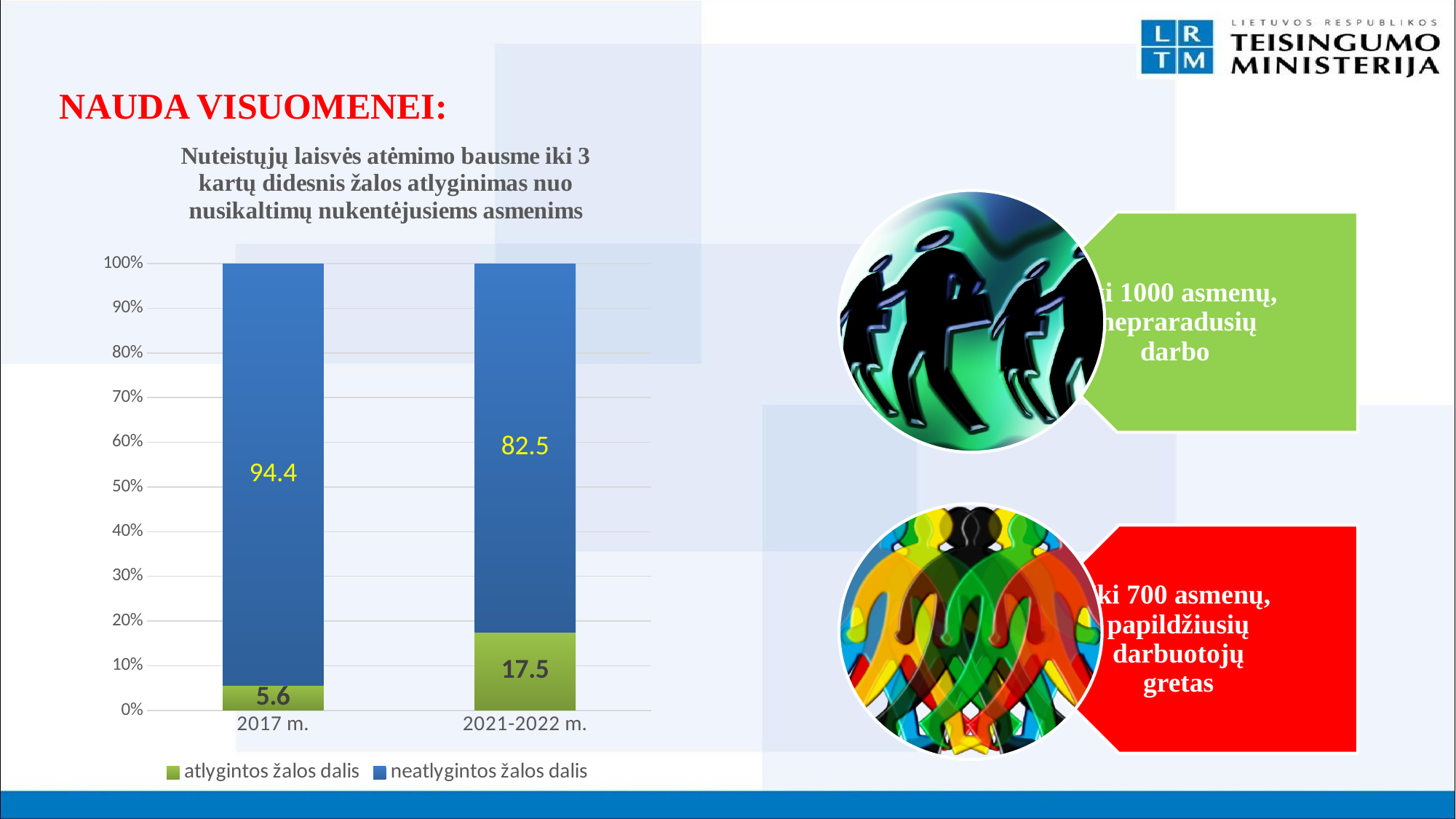
Which category has the lowest value for neatlygintos žalos dalis? 2021-2022 m. What is the difference between the neatlygintos žalos dalis values for 2017 m. and 2021-2022 m.? 11.9 Which category has the higher value for atlygintos žalos dalis, 2017 m. or 2021-2022 m.? 2021-2022 m. How many series does the chart legend list? 2 What is the difference between the atlygintos žalos dalis values for 2021-2022 m. and 2017 m.? 11.9 How many categories are shown on the x axis of the chart? 2 What type of chart is shown on the slide? Stacked bar chart What is the value of atlygintos žalos dalis for 2021-2022 m.? 17.5 Which colour represents neatlygintos žalos dalis in the chart? Blue What is the value of neatlygintos žalos dalis for 2021-2022 m.? 82.5 What is the value of atlygintos žalos dalis for 2017 m.? 5.6 What is the value of neatlygintos žalos dalis for 2017 m.? 94.4